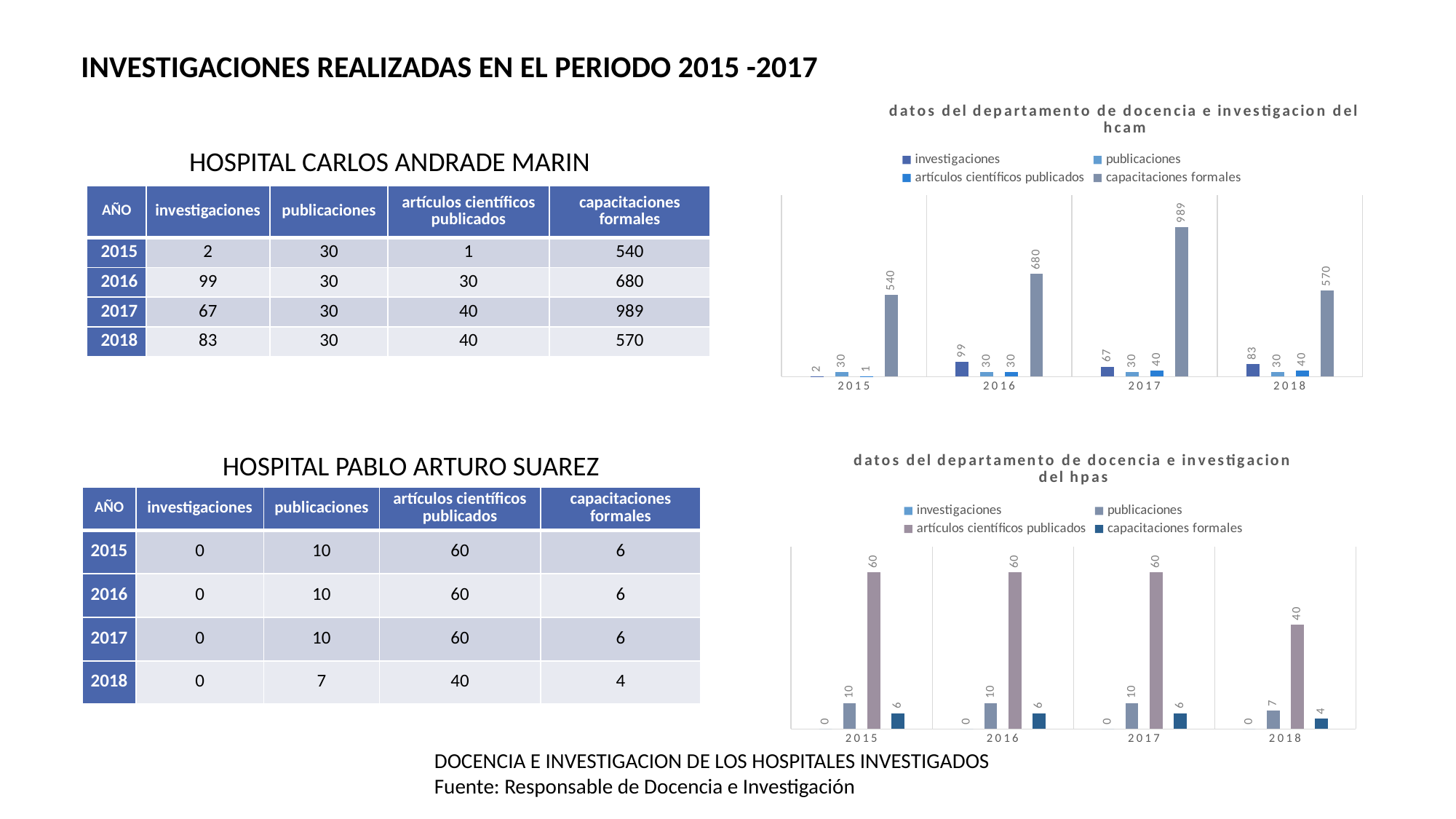
In the chart titled 'datos del departamento de docencia e investigacion del hpas', what is the value for publicaciones in 2018? 7 In the chart titled 'datos del departamento de docencia e investigacion del hpas', what is the value for artículos científicos publicados in 2018? 40 In the chart titled 'datos del departamento de docencia e investigacion del hcam', which year has the highest value for capacitaciones formales? 2017 In the chart titled 'datos del departamento de docencia e investigacion del hpas', how many years are shown on the x axis? 4 What type of chart is the chart titled 'datos del departamento de docencia e investigacion del hpas'? bar chart In the chart titled 'datos del departamento de docencia e investigacion del hpas', which year has the lowest value for capacitaciones formales? 2018 In the chart titled 'datos del departamento de docencia e investigacion del hpas', is the value for artículos científicos publicados in 2017 larger or smaller than the value for publicaciones in 2017? larger In the chart titled 'datos del departamento de docencia e investigacion del hcam', what is the value for capacitaciones formales in 2017? 989 In the chart titled 'datos del departamento de docencia e investigacion del hcam', what is the difference between capacitaciones formales in 2017 and 2018? 419 In the chart titled 'datos del departamento de docencia e investigacion del hcam', which year has the lowest value for investigaciones? 2015 In the chart titled 'datos del departamento de docencia e investigacion del hcam', what is the value for investigaciones in 2016? 99 In the chart titled 'datos del departamento de docencia e investigacion del hcam', how many series does the legend list? 4